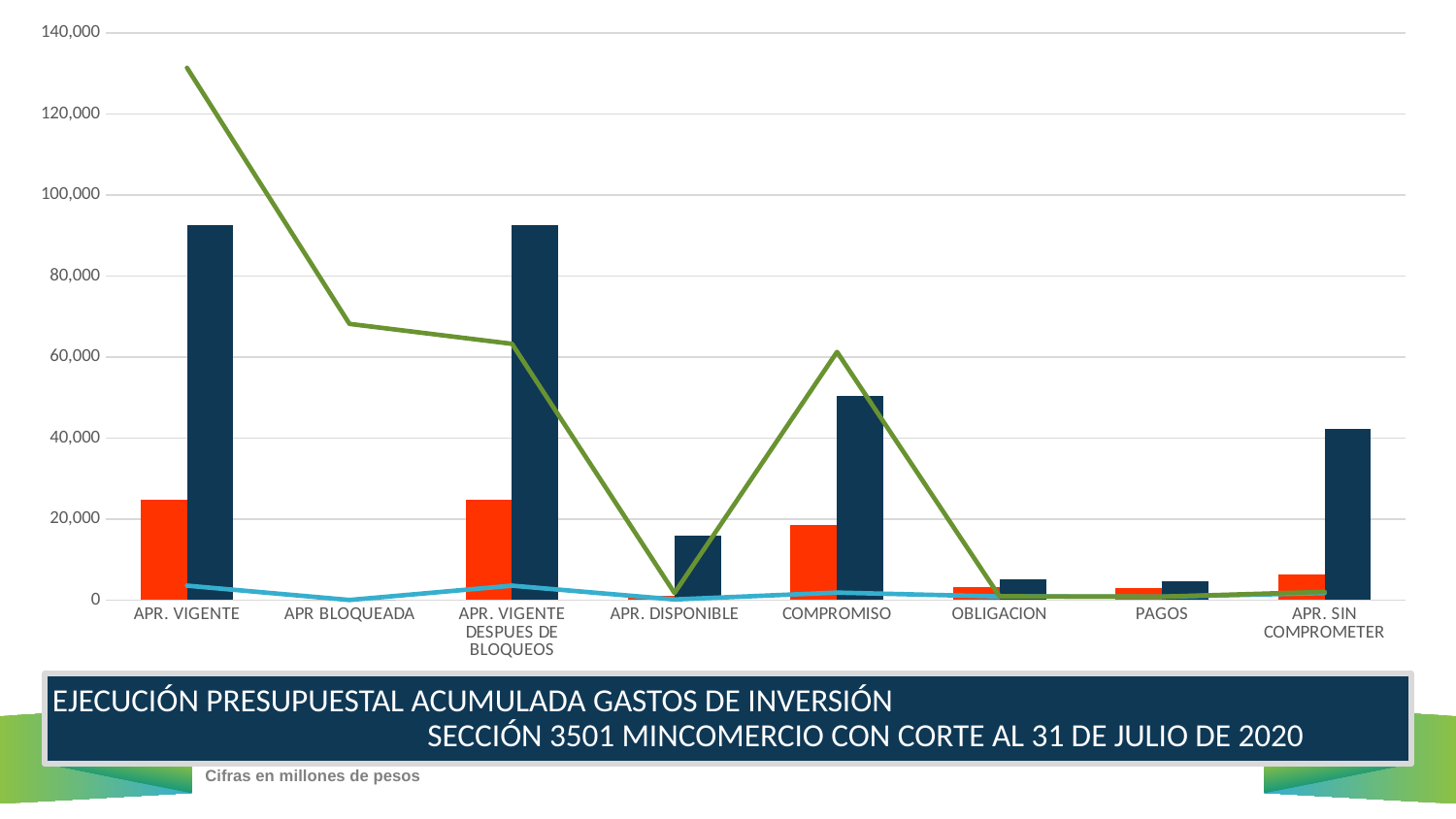
At which category does the green line reach its highest value? APR. VIGENTE Is the value of the orange bar for APR. VIGENTE greater or less than 20,000? greater Is the value of the dark blue bar for APR. VIGENTE greater or less than 80,000? greater Is the value of the green line at APR. VIGENTE greater or less than 120,000? greater In what units are the figures in the chart expressed, according to the note on the slide? Millones de pesos Which has the taller dark blue bar, APR. VIGENTE or COMPROMISO? APR. VIGENTE Does the green line rise or fall from APR. VIGENTE to APR. DISPONIBLE? fall What kind of chart is shown on the slide? A combination chart with bars and lines How many categories are shown on the x axis of the chart? 8 Which has the taller dark blue bar, COMPROMISO or APR. SIN COMPROMETER? COMPROMISO